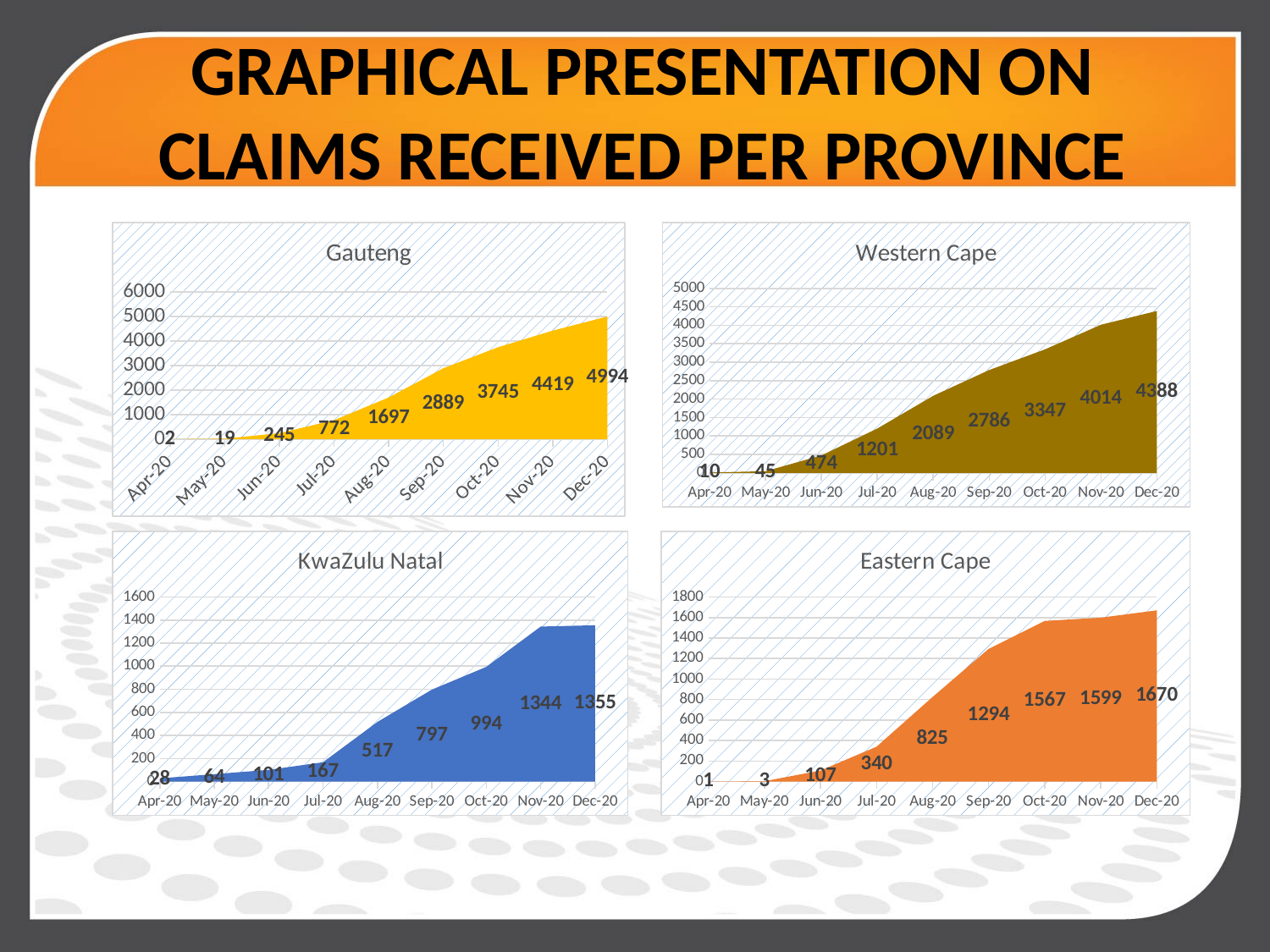
In the Western Cape chart, what is the value for Aug-20? 2089 In the Eastern Cape chart, what is the value for Jul-20? 340 In the KwaZulu Natal chart, is the value for Nov-20 greater or less than 1200? greater How many months are plotted on the x axis of the Eastern Cape chart? 9 In the KwaZulu Natal chart, what is the value for Sep-20? 797 In the Gauteng chart, which month has the highest value? Dec-20 In the Western Cape chart, do the values rise or fall from Apr-20 to Dec-20? Rise What kind of chart is the KwaZulu Natal chart? Area chart In the Eastern Cape chart, what is the difference between the Dec-20 and Nov-20 values? 71 In the Western Cape chart, what is the difference between the Nov-20 and Oct-20 values? 667 In the Gauteng chart, what is the value for Dec-20? 4994 Which is larger: the Dec-20 value in the Gauteng chart or the Dec-20 value in the Western Cape chart? Gauteng